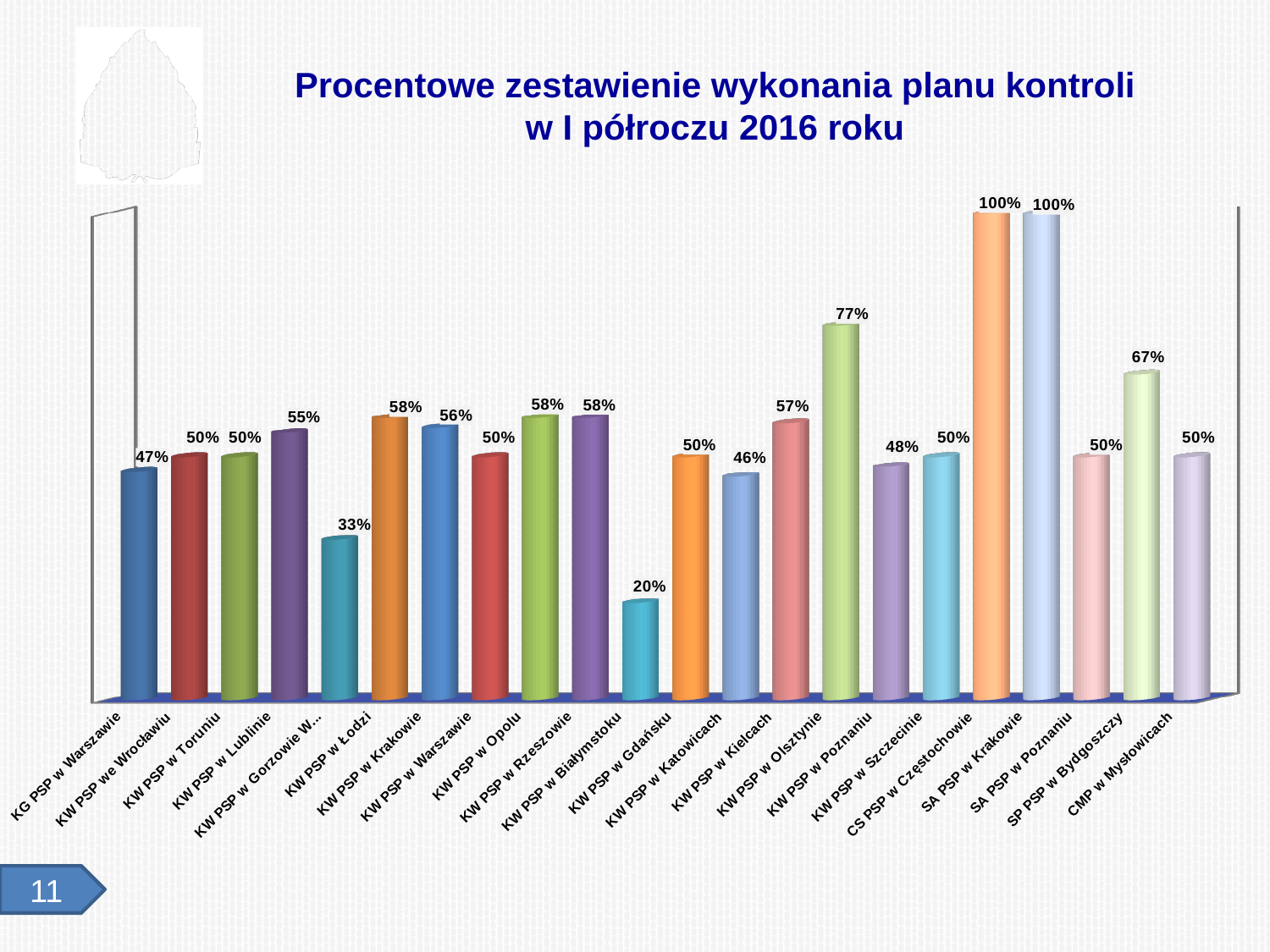
What is the value for KW PSP w Białymstoku? 20% How many categories are shown on the chart? 22 What is the highest value shown on the chart? 100% Which category has the lowest value? KW PSP w Białymstoku What kind of chart is shown on the slide? Bar chart Which is larger, the value for KW PSP w Kielcach or the value for KW PSP w Katowicach? KW PSP w Kielcach What is the value for KW PSP w Gorzowie W...? 33% What is the difference between the values for KW PSP w Olsztynie and KW PSP w Białymstoku? 57% What is the value for KG PSP w Warszawie? 47% What is the value for KW PSP w Olsztynie? 77% What is the title of the chart? Procentowe zestawienie wykonania planu kontroli w I półroczu 2016 roku What is the value for SP PSP w Bydgoszczy? 67%